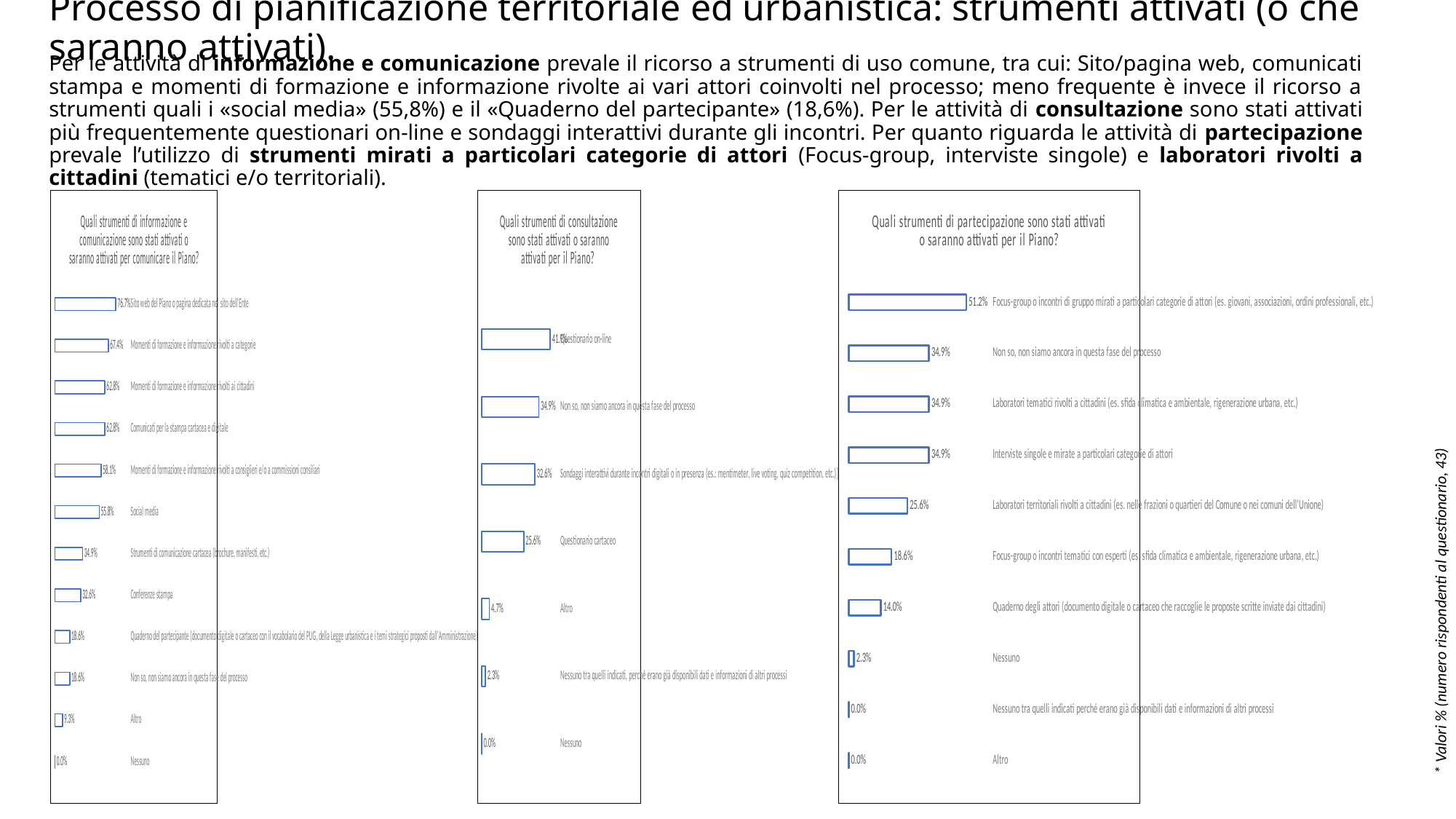
What type of chart is the right chart on participation tools? Bar chart In the middle chart on consultation tools, which category has the highest value? Questionario on-line In the left chart on information and communication tools, what is the value for Conferenze stampa? 32.6% How many categories are shown in the left chart on information and communication tools? 12 In the right chart on participation tools, what is the value for Quaderno degli attori? 14.0% In the right chart on participation tools, which is larger: Laboratori territoriali rivolti a cittadini or Focus-group o incontri tematici con esperti? Laboratori territoriali rivolti a cittadini In the middle chart on consultation tools, what is the value for Sondaggi interattivi durante incontri digitali o in presenza? 32.6% In the left chart on information and communication tools, which category has the highest value? Sito web del Piano o pagina dedicata nel sito dell'Ente In the right chart on participation tools, what is the value for Focus-group o incontri di gruppo mirati a particolari categorie di attori? 51.2% In the middle chart on consultation tools, what is the value for Questionario cartaceo? 25.6% In the left chart on information and communication tools, what is the difference between Sito web del Piano (76.7%) and Social media (55.8%)? 20.9% In the left chart on information and communication tools, what is the value for Social media? 55.8%